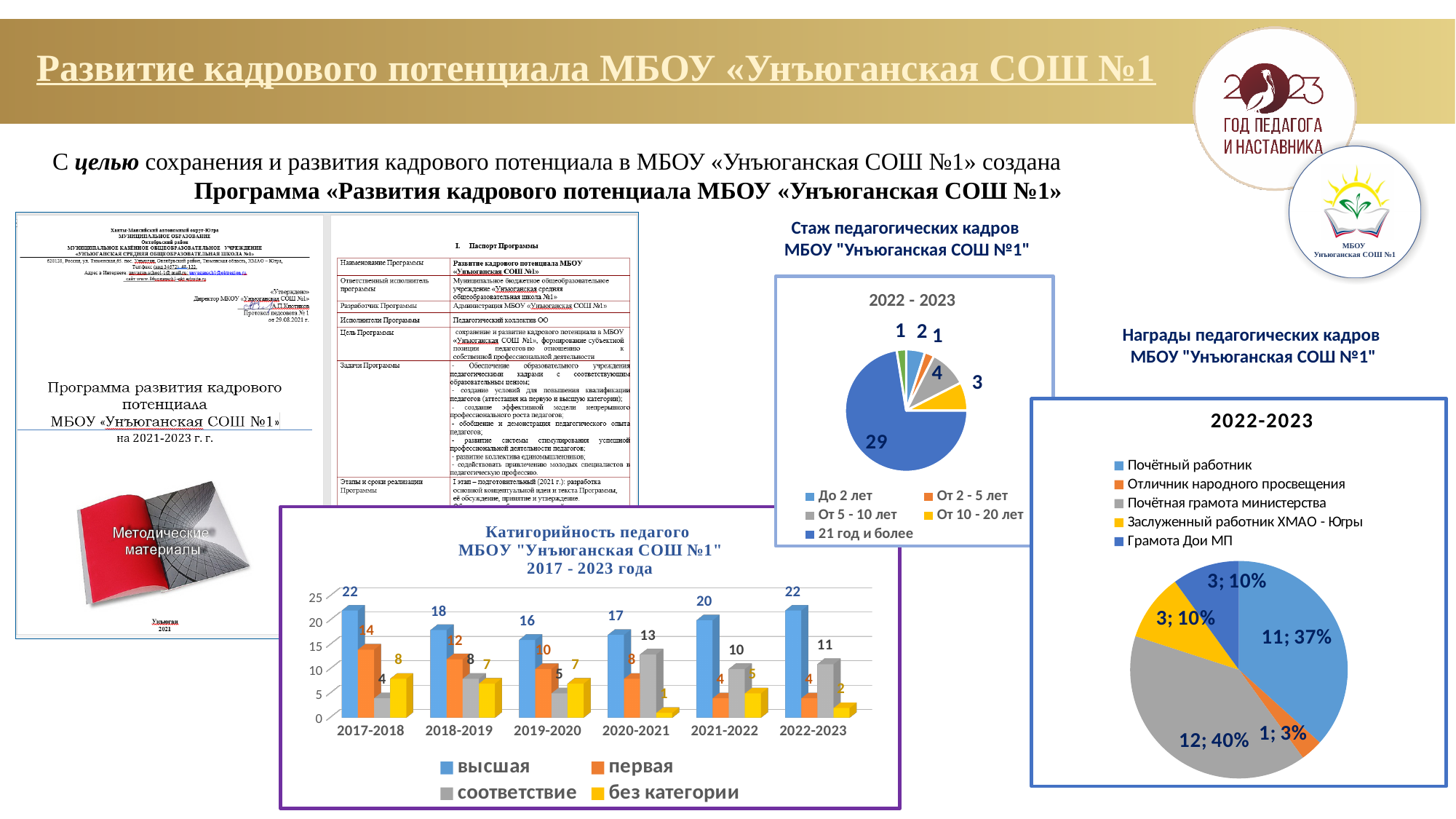
In the chart "Категорийность педагого", what is the difference between "высшая" and "первая" in 2022-2023? 18 In the chart "Категорийность педагого", which is larger in 2021-2022: "соответствие" or "без категории"? соответствие In the chart "Стаж педагогических кадров", which category has the highest value? 21 год и более In the chart "Категорийность педагого", how many series does the legend list? 4 In the chart "Категорийность педагого", how many school-year categories are shown on the x axis? 6 What kind of chart is "Стаж педагогических кадров"? pie chart In the chart "Награды педагогических кадров", what share does "Почётная грамота министерства" have? 40% In the chart "Стаж педагогических кадров", what is the value for "От 5 - 10 лет"? 4 In the chart "Награды педагогических кадров", which category has the lowest value? Отличник народного просвещения In the chart "Категорийность педагого", what is the value for "соответствие" in 2020-2021? 13 In the chart "Категорийность педагого", what is the value for "высшая" in 2017-2018? 22 In the chart "Стаж педагогических кадров", what is the value for "21 год и более"? 29